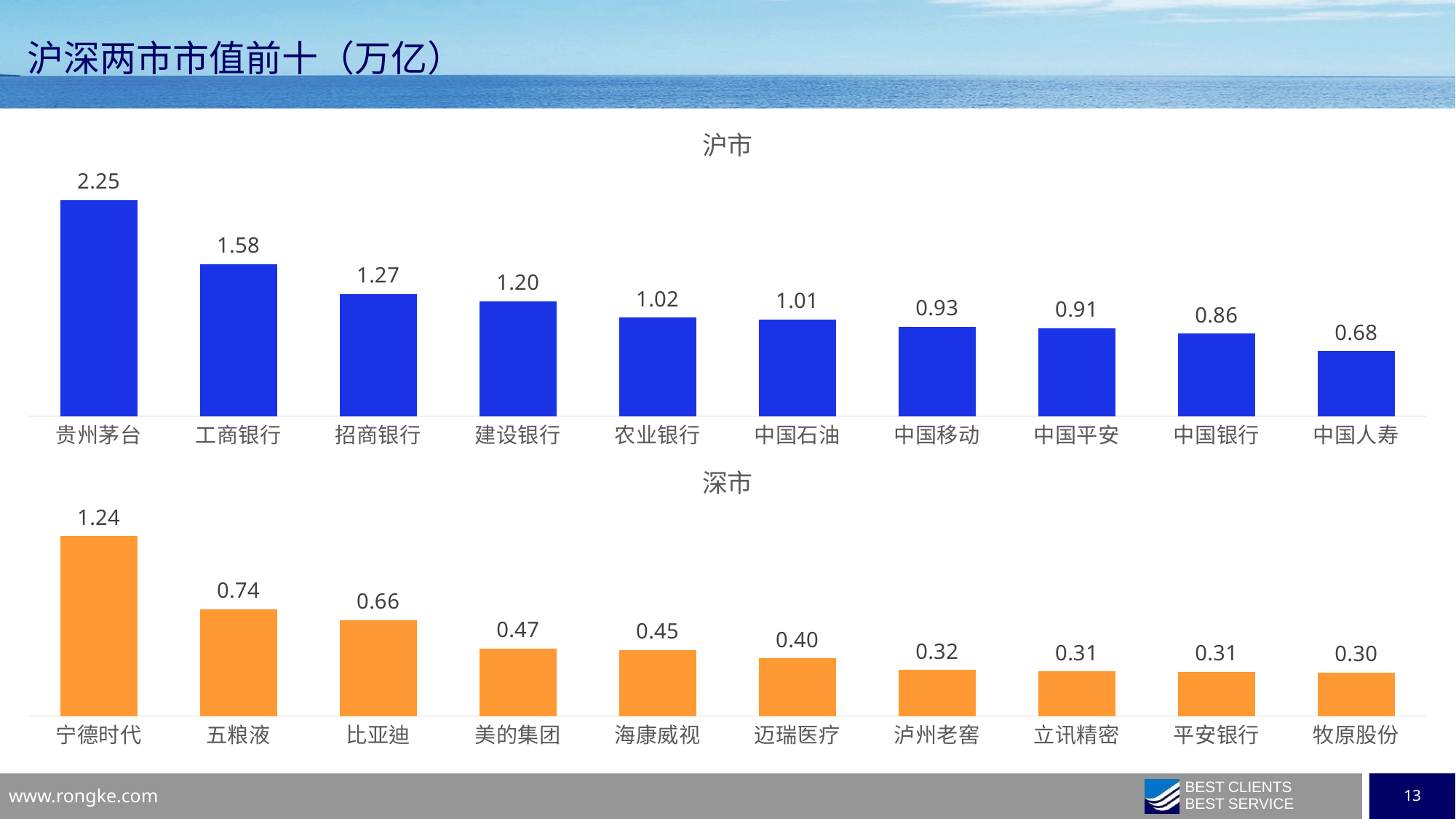
What kind of chart is the 深市 chart? Bar chart In the 深市 chart, which category has the highest value? 宁德时代 In the 深市 chart, what is the value for 比亚迪? 0.66 How many categories are shown in the 深市 chart? 10 In the 沪市 chart, which is larger, the value for 招商银行 or the value for 建设银行? 招商银行 How many categories are shown in the 沪市 chart? 10 In the 沪市 chart, which category has the lowest value? 中国人寿 In the 深市 chart, which is larger, the value for 美的集团 or the value for 迈瑞医疗? 美的集团 In the 深市 chart, what is the difference between the values for 宁德时代 and 五粮液? 0.50 In the 沪市 chart, what is the difference between the values for 贵州茅台 and 工商银行? 0.67 In the 沪市 chart, what is the value for 贵州茅台? 2.25 In the 沪市 chart, do the values rise or fall from left to right along the x axis? Fall